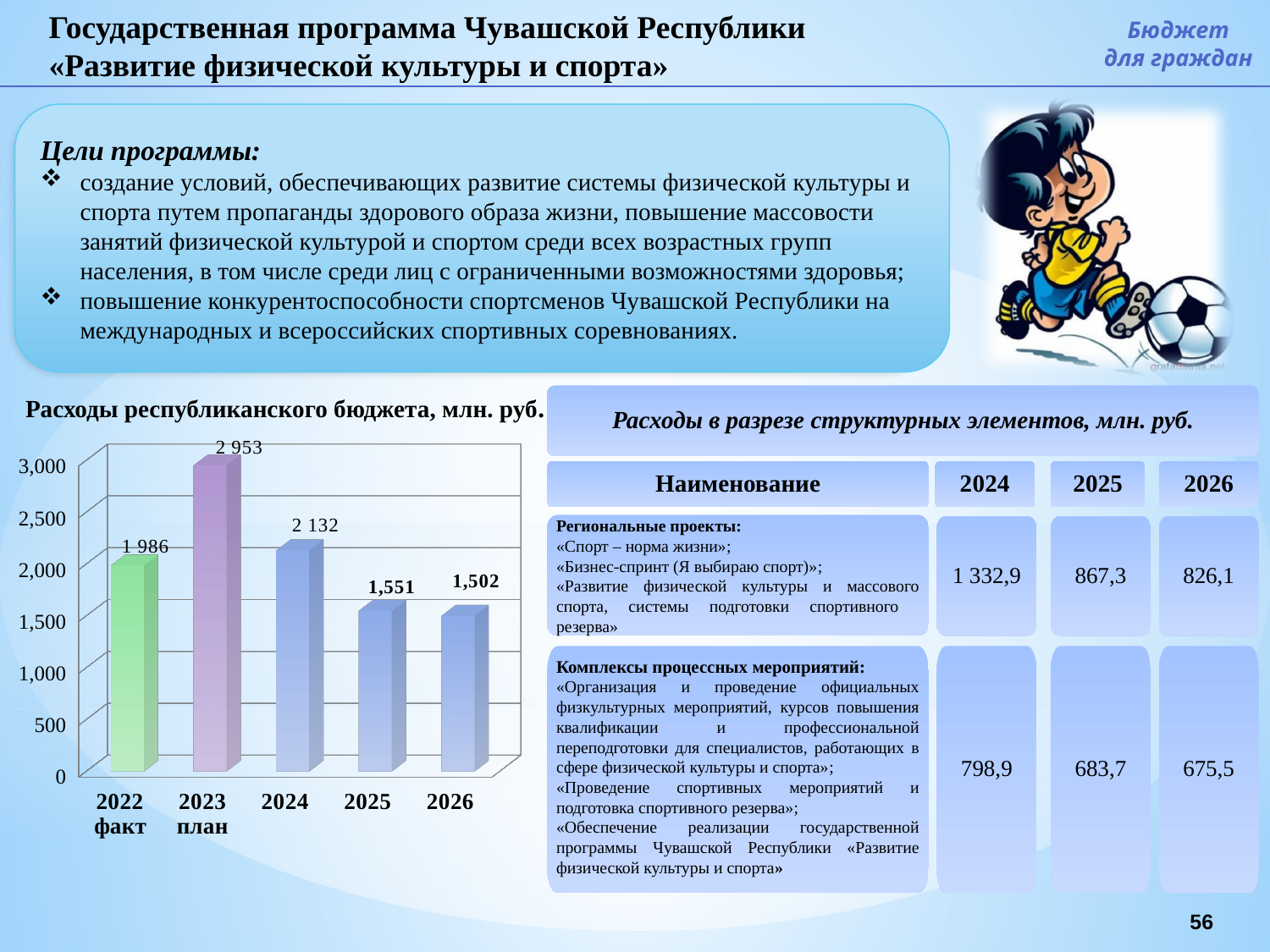
In the chart 'Расходы республиканского бюджета, млн. руб.', what is the difference between the values for 2024 and 2025? 581 Which year has the highest value in the chart 'Расходы республиканского бюджета, млн. руб.'? 2023 план In the chart 'Расходы республиканского бюджета, млн. руб.', do the values rise or fall from 2023 план to 2026? Fall What is the value for 2022 факт in the chart 'Расходы республиканского бюджета, млн. руб.'? 1 986 What type of chart is 'Расходы республиканского бюджета, млн. руб.'? Bar chart What is the value for 2023 план in the chart 'Расходы республиканского бюджета, млн. руб.'? 2 953 In the chart 'Расходы республиканского бюджета, млн. руб.', which is larger: the value for 2022 факт or the value for 2024? 2024 What is the value for 2026 in the chart 'Расходы республиканского бюджета, млн. руб.'? 1,502 What is the value for 2024 in the chart 'Расходы республиканского бюджета, млн. руб.'? 2 132 How many bars are shown in the chart 'Расходы республиканского бюджета, млн. руб.'? 5 Which year has the lowest value in the chart 'Расходы республиканского бюджета, млн. руб.'? 2026 In the chart 'Расходы республиканского бюджета, млн. руб.', what is the difference between the values for 2023 план and 2022 факт? 967